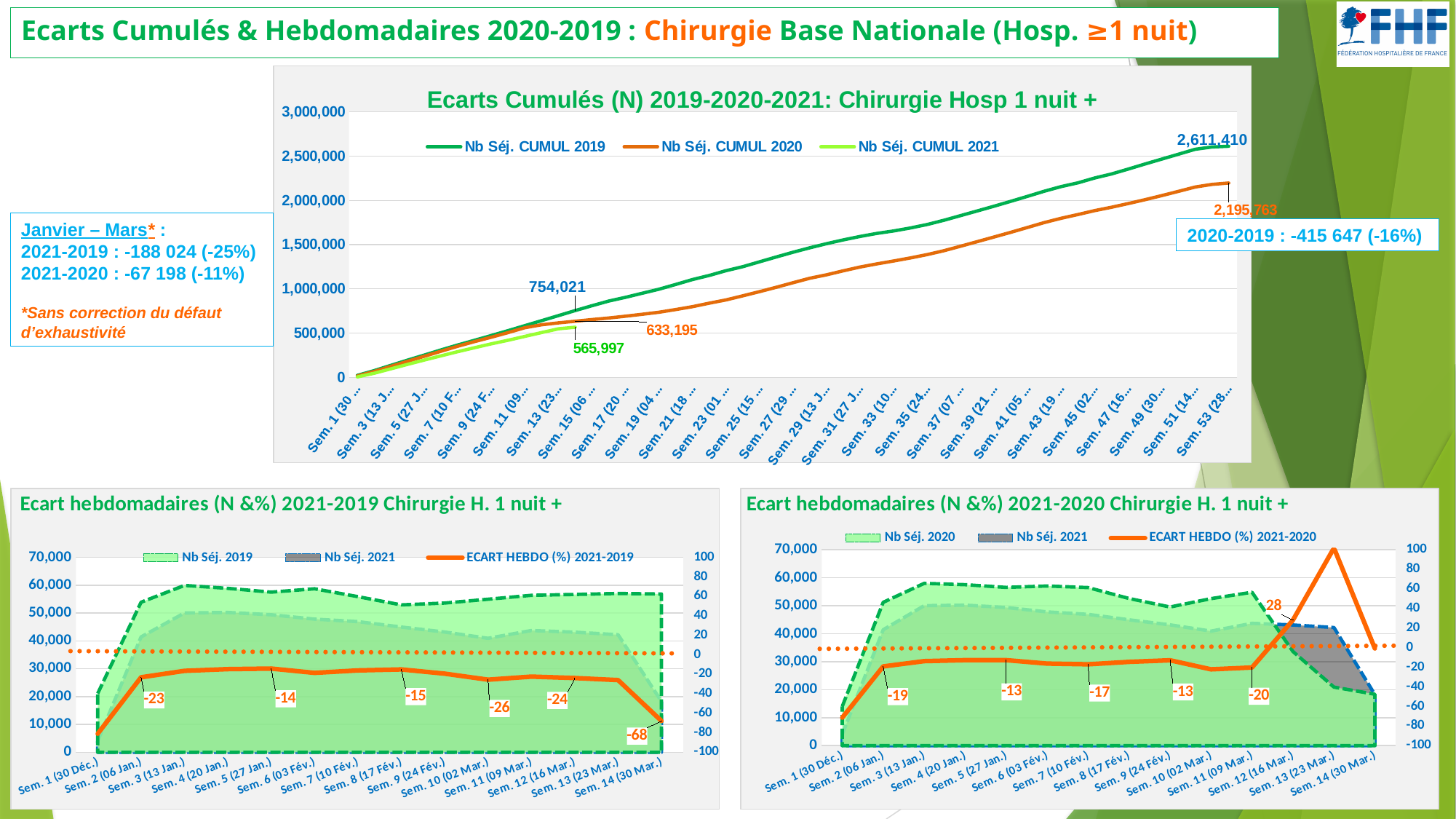
What kind of chart is the top chart 'Ecarts Cumulés (N) 2019-2020-2021'? Line chart In the top chart 'Ecarts Cumulés (N) 2019-2020-2021', how many series does the legend list? 3 In the bottom-left chart 'Ecart hebdomadaires (N &%) 2021-2019', which is larger: the ECART HEBDO (%) at Sem. 2 (06 Jan.) or at Sem. 5 (27 Jan.)? Sem. 5 (27 Jan.) In the top chart 'Ecarts Cumulés (N) 2019-2020-2021', do the cumulative series rise or fall along the x axis? Rise In the top chart 'Ecarts Cumulés (N) 2019-2020-2021', what is the difference between the labelled values 754,021 (CUMUL 2019) and 633,195 (CUMUL 2020)? 120,826 In the bottom-left chart 'Ecart hebdomadaires (N &%) 2021-2019', how many weeks are shown on the x axis? 14 In the bottom-right chart 'Ecart hebdomadaires (N &%) 2021-2020', which week has the highest ECART HEBDO (%) value? Sem. 13 (23 Mar.) In the bottom-left chart 'Ecart hebdomadaires (N &%) 2021-2019', which week has the lowest ECART HEBDO (%) value? Sem. 1 (30 Déc.) In the bottom-left chart 'Ecart hebdomadaires (N &%) 2021-2019', what is the labelled ECART HEBDO (%) value at Sem. 14 (30 Mar.)? -68 In the top chart 'Ecarts Cumulés (N) 2019-2020-2021', what is the final labelled value of Nb Séj. CUMUL 2020? 2,195,763 In the bottom-right chart 'Ecart hebdomadaires (N &%) 2021-2020', what is the labelled ECART HEBDO (%) value at Sem. 12 (16 Mar.)? 28 In the top chart 'Ecarts Cumulés (N) 2019-2020-2021', what is the final labelled value of Nb Séj. CUMUL 2019? 2,611,410